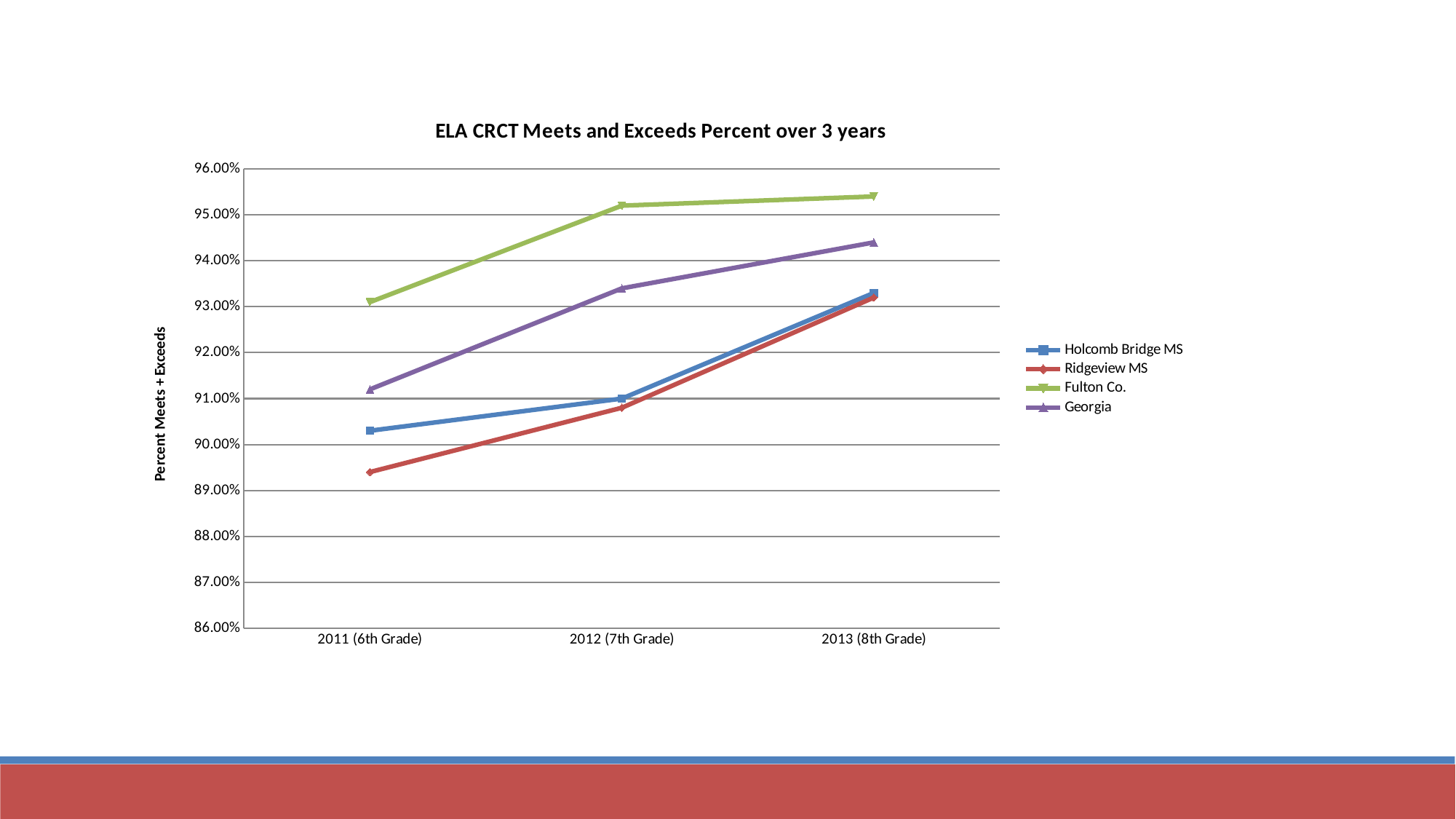
What kind of chart is shown on the slide? line chart Is the value for Fulton Co. in 2013 (8th Grade) greater or less than 95.00%? greater How many series does the legend list? 4 Which series has the lowest value in 2011 (6th Grade)? Ridgeview MS How many points along the x axis does each line have? 3 Is the value for Ridgeview MS in 2011 (6th Grade) greater or less than 90.00%? less Which series has the highest value in 2013 (8th Grade)? Fulton Co. What is the title of the chart? ELA CRCT Meets and Exceeds Percent over 3 years What is the label on the vertical axis? Percent Meets + Exceeds Does the Holcomb Bridge MS line rise or fall from 2011 (6th Grade) to 2013 (8th Grade)? rise In 2012 (7th Grade), which is larger: the value for Georgia or the value for Holcomb Bridge MS? Georgia Is the value for Georgia in 2013 (8th Grade) greater or less than 94.00%? greater